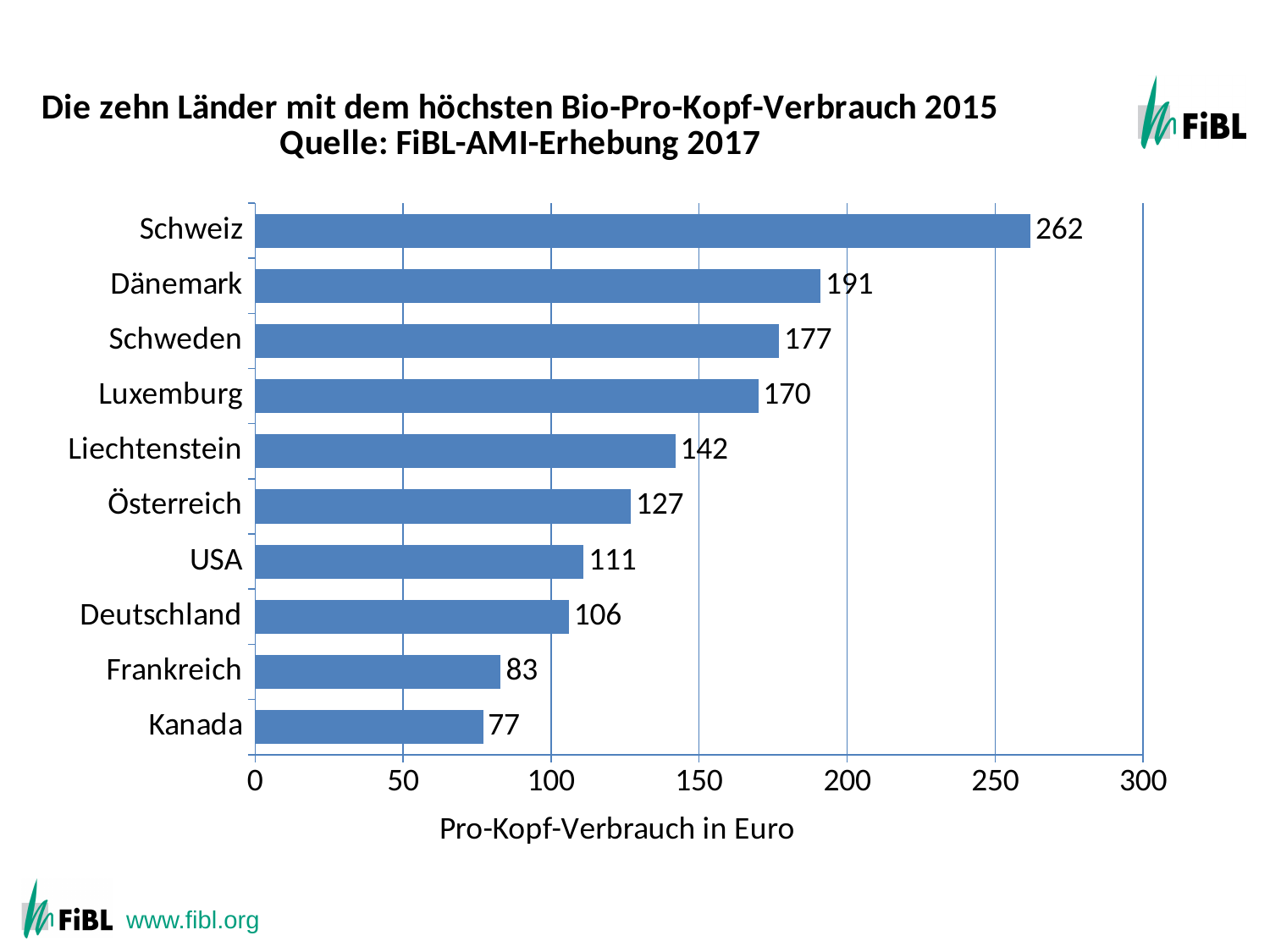
How many countries are shown in the chart? 10 What is the difference between the values for Frankreich and Kanada? 6 What value is shown for Liechtenstein? 142 Is the value for Österreich greater or less than 150? less What is the label of the horizontal axis? Pro-Kopf-Verbrauch in Euro Which has a higher value, Schweden or Luxemburg? Schweden What is the difference between the values for Schweiz and Dänemark? 71 Which country has the lowest per-capita consumption in the chart? Kanada What value is shown for Deutschland? 106 What is the per-capita organic consumption value shown for Schweiz? 262 Which country has the highest per-capita consumption in the chart? Schweiz What kind of chart is shown on the slide? bar chart